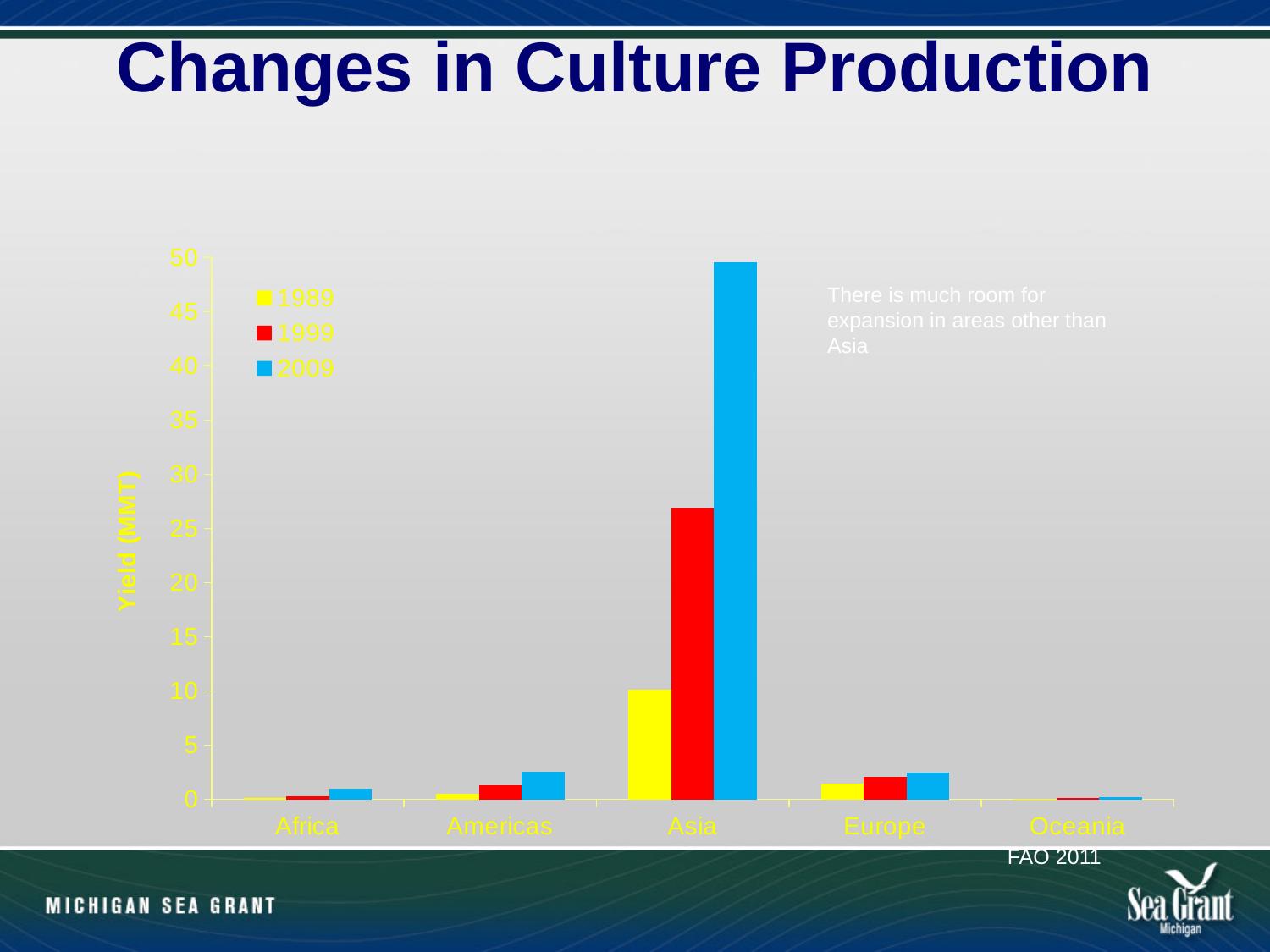
Is the 1999 value for Asia greater or less than 25? greater How many regions are shown on the x axis of the chart? 5 Which region has the lowest yield in 2009? Oceania Which region has the highest yield in 2009? Asia Is the 2009 value for Europe greater or less than 5? less How many series does the chart's legend list? 3 Which years are listed in the chart's legend? 1989, 1999, 2009 What is the title of the y axis? Yield (MMT) For Asia, which is larger: the 1989 value or the 1999 value? 1999 Is the 2009 value for Asia greater or less than 45? greater Do the values for Asia rise or fall from 1989 to 2009? rise What kind of chart is shown on the slide? bar chart